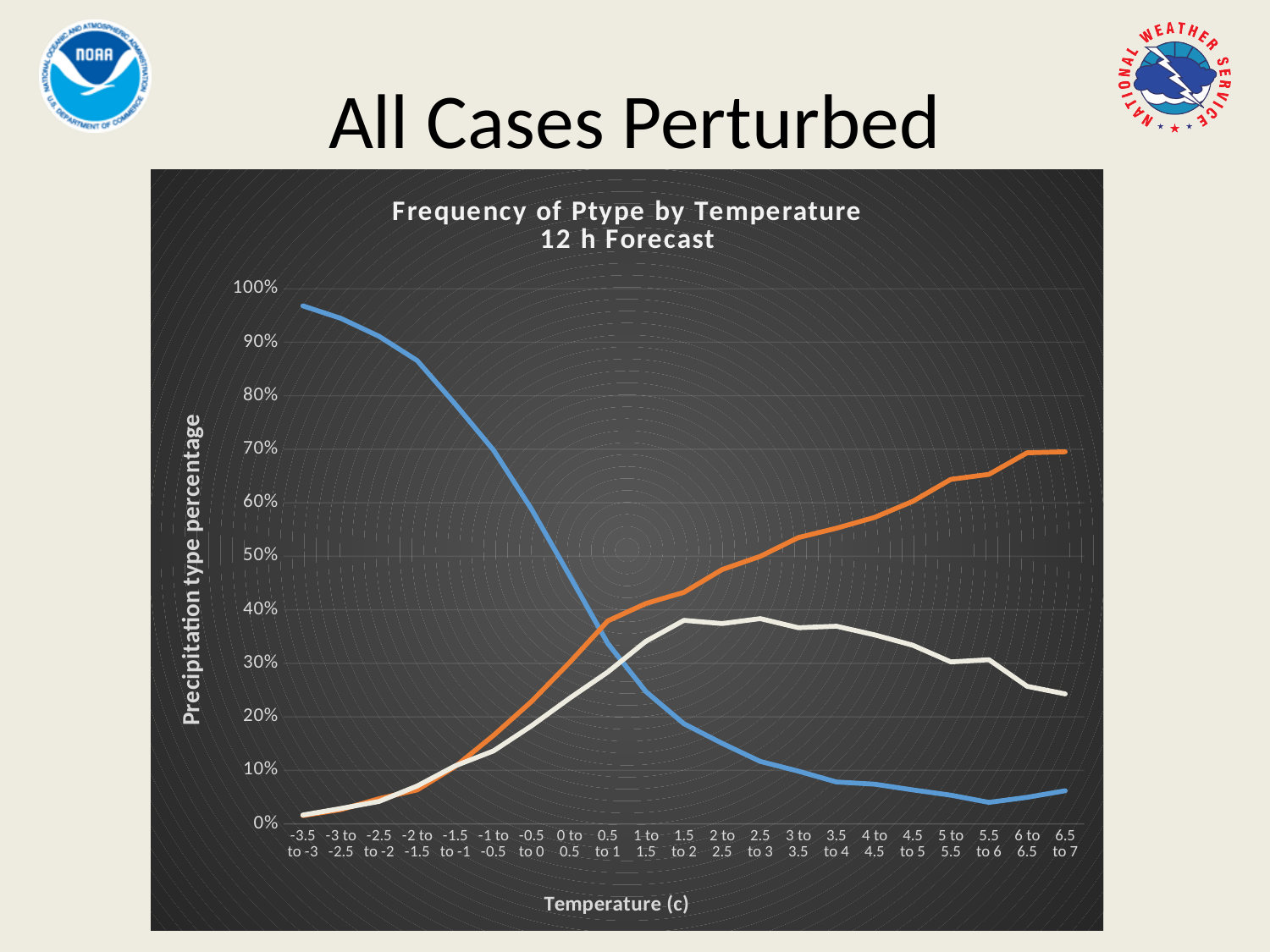
How many temperature categories are shown along the x axis? 21 Is the value of the orange line at 6.5 to 7 greater or less than 60%? greater Is the value of the white line at 6.5 to 7 greater or less than 30%? less Is the value of the blue line at -3.5 to -3 greater or less than 90%? greater What kind of chart is shown on the slide? Line chart Does the orange line rise or fall as temperature increases along the x axis? Rise What is the title of the chart? Frequency of Ptype by Temperature 12 h Forecast At 6.5 to 7, which line has the larger value, the orange line or the blue line? Orange line Does the blue line rise or fall as temperature increases along the x axis? Fall What is the label on the vertical axis of the chart? Precipitation type percentage How many lines are plotted on the chart? 3